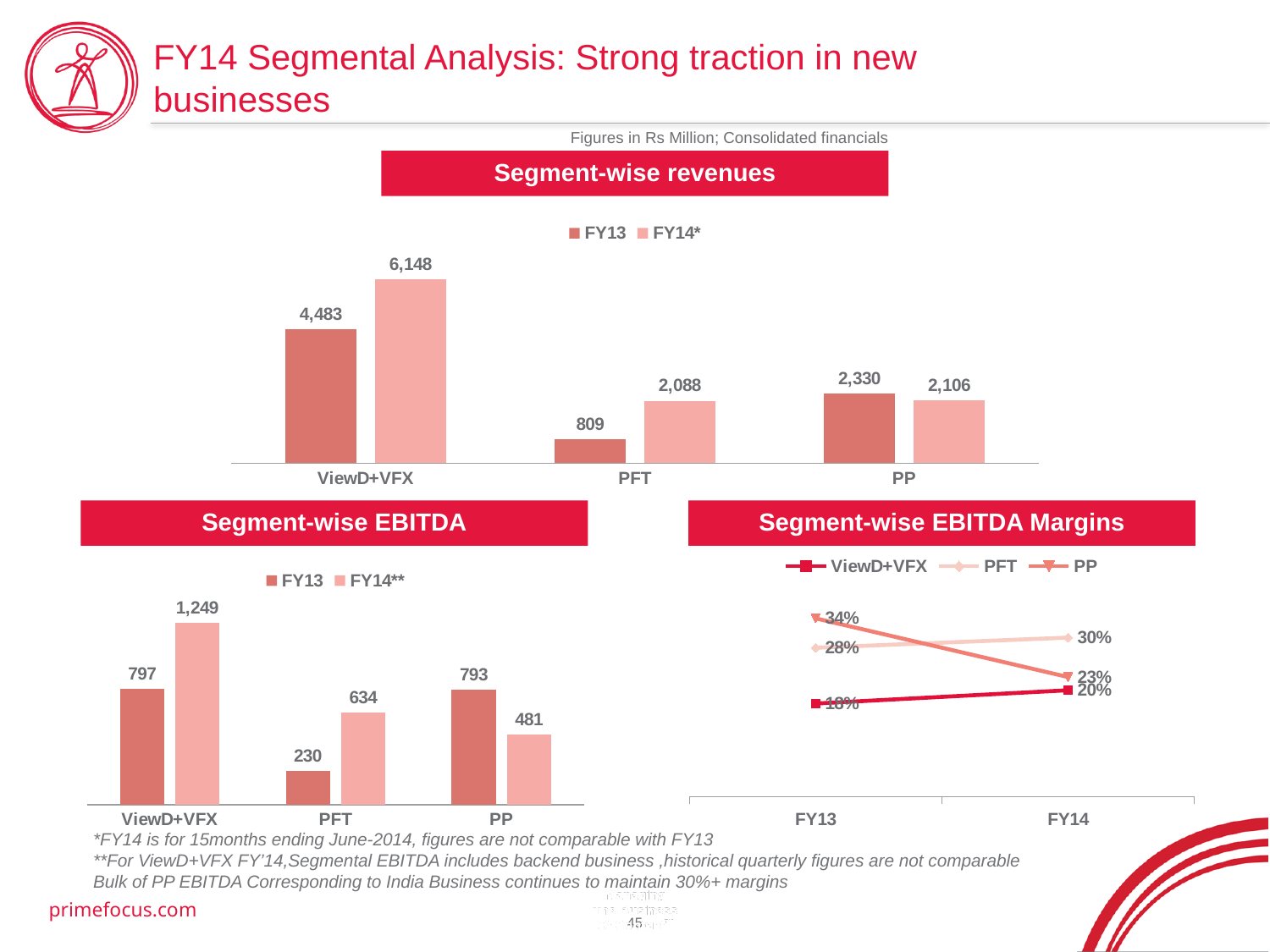
What kind of chart is the Segment-wise EBITDA Margins chart? line chart In the Segment-wise EBITDA chart, what is the FY14** EBITDA for PFT? 634 In the Segment-wise revenues chart, what is the FY14* revenue for ViewD+VFX? 6,148 In the Segment-wise EBITDA chart, what is the difference between the FY13 and FY14** EBITDA for PP? 312 How many series does the legend of the Segment-wise EBITDA chart list? 2 In the Segment-wise revenues chart, is the FY13 revenue for PP larger or smaller than its FY14* revenue? larger In the Segment-wise EBITDA Margins chart, does the PP margin rise or fall from FY13 to FY14? fall In the Segment-wise revenues chart, what is the FY13 revenue for PFT? 809 In the Segment-wise revenues chart, what is the difference between the FY14* and FY13 revenue for PFT? 1,279 In the Segment-wise revenues chart, which segment has the highest FY14* revenue? ViewD+VFX In the Segment-wise EBITDA Margins chart, what is the EBITDA margin for PFT in FY14? 30% In the Segment-wise EBITDA chart, which segment has the lowest FY13 EBITDA? PFT